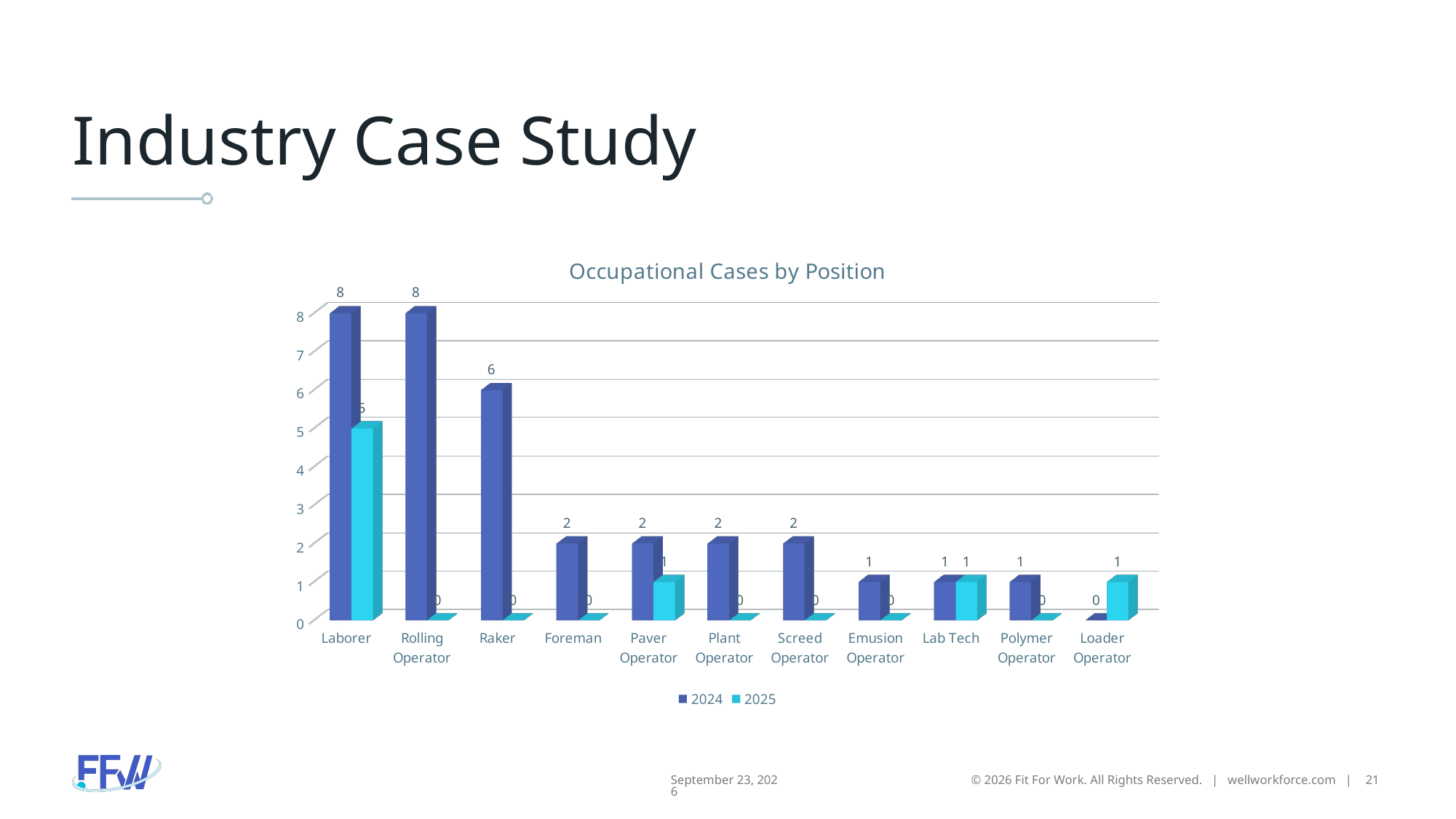
What is the 2024 value for Loader Operator? 0 How many series does the legend list? 2 How many positions are shown on the x axis? 11 What kind of chart is shown on the slide? Bar chart What is the 2024 value for Raker? 6 What is the 2025 value for Laborer? 5 What is the 2025 value for Paver Operator? 1 Which is larger for Lab Tech, the 2024 value or the 2025 value? They are equal What is the difference between the 2024 and 2025 values for Laborer? 3 Which position has the lowest 2024 value? Loader Operator What is the title of the chart? Occupational Cases by Position Which position has the highest 2025 value? Laborer